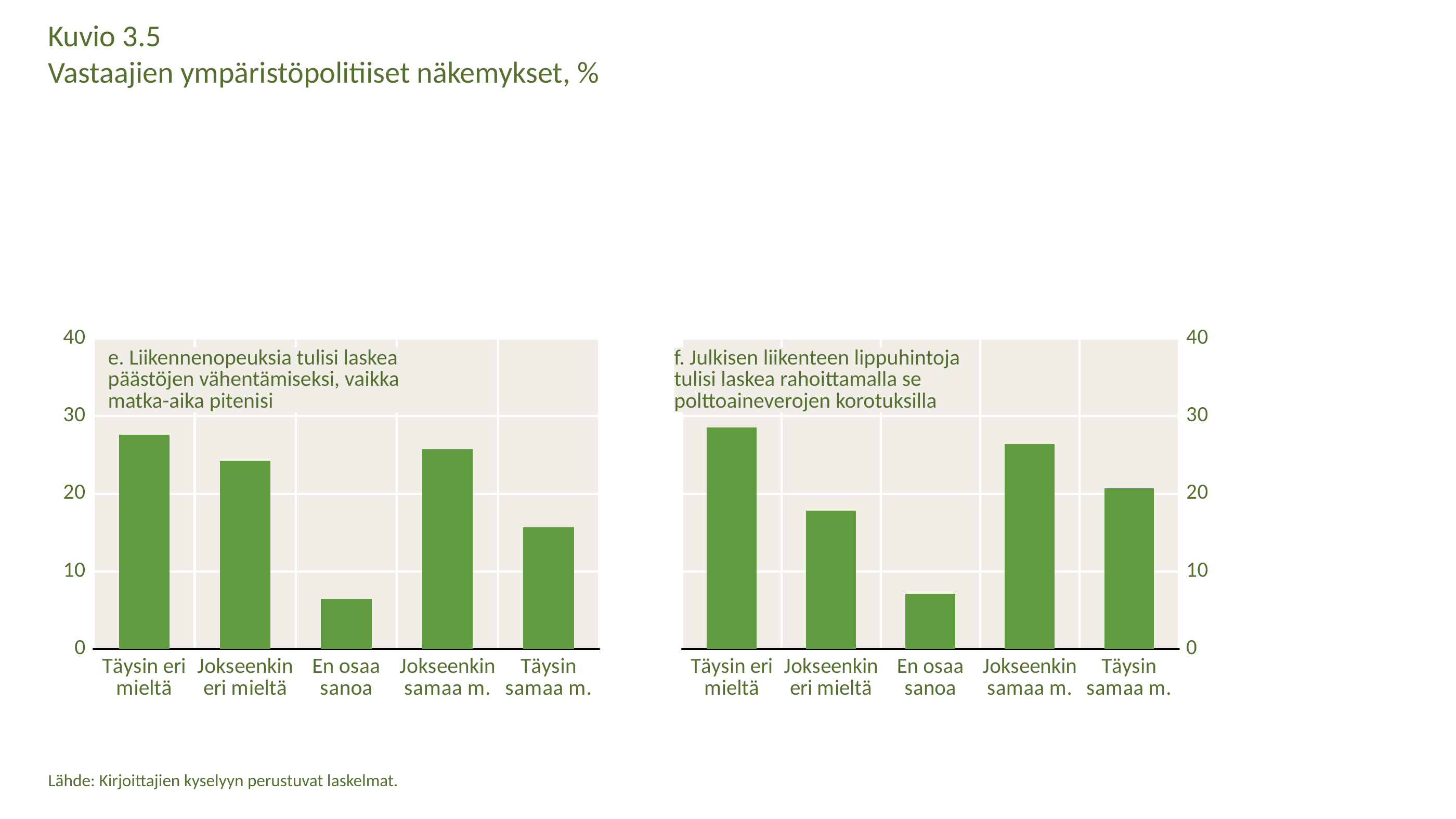
How many categories are shown on the x axis of the right chart (f. Julkisen liikenteen lippuhintoja...)? 5 In the right chart (f. Julkisen liikenteen lippuhintoja...), which category has the lowest bar? En osaa sanoa What kind of chart is the left chart (e. Liikennenopeuksia tulisi laskea...)? bar chart In the right chart (f. Julkisen liikenteen lippuhintoja...), is the value for Täysin eri mieltä greater or less than 20? greater In the left chart (e. Liikennenopeuksia tulisi laskea...), which category has the lowest bar? En osaa sanoa In the left chart (e. Liikennenopeuksia tulisi laskea...), is the value for Täysin samaa m. greater or less than 20? less In the left chart (e. Liikennenopeuksia tulisi laskea...), is the value for En osaa sanoa greater or less than 10? less In the right chart (f. Julkisen liikenteen lippuhintoja...), which is larger: Jokseenkin samaa m. or Jokseenkin eri mieltä? Jokseenkin samaa m. In the right chart (f. Julkisen liikenteen lippuhintoja...), which category has the highest bar? Täysin eri mieltä What is the main title of the slide above the charts? Kuvio 3.5 Vastaajien ympäristöpolitiiset näkemykset, % In the left chart (e. Liikennenopeuksia tulisi laskea...), which is larger: Jokseenkin eri mieltä or Täysin samaa m.? Jokseenkin eri mieltä